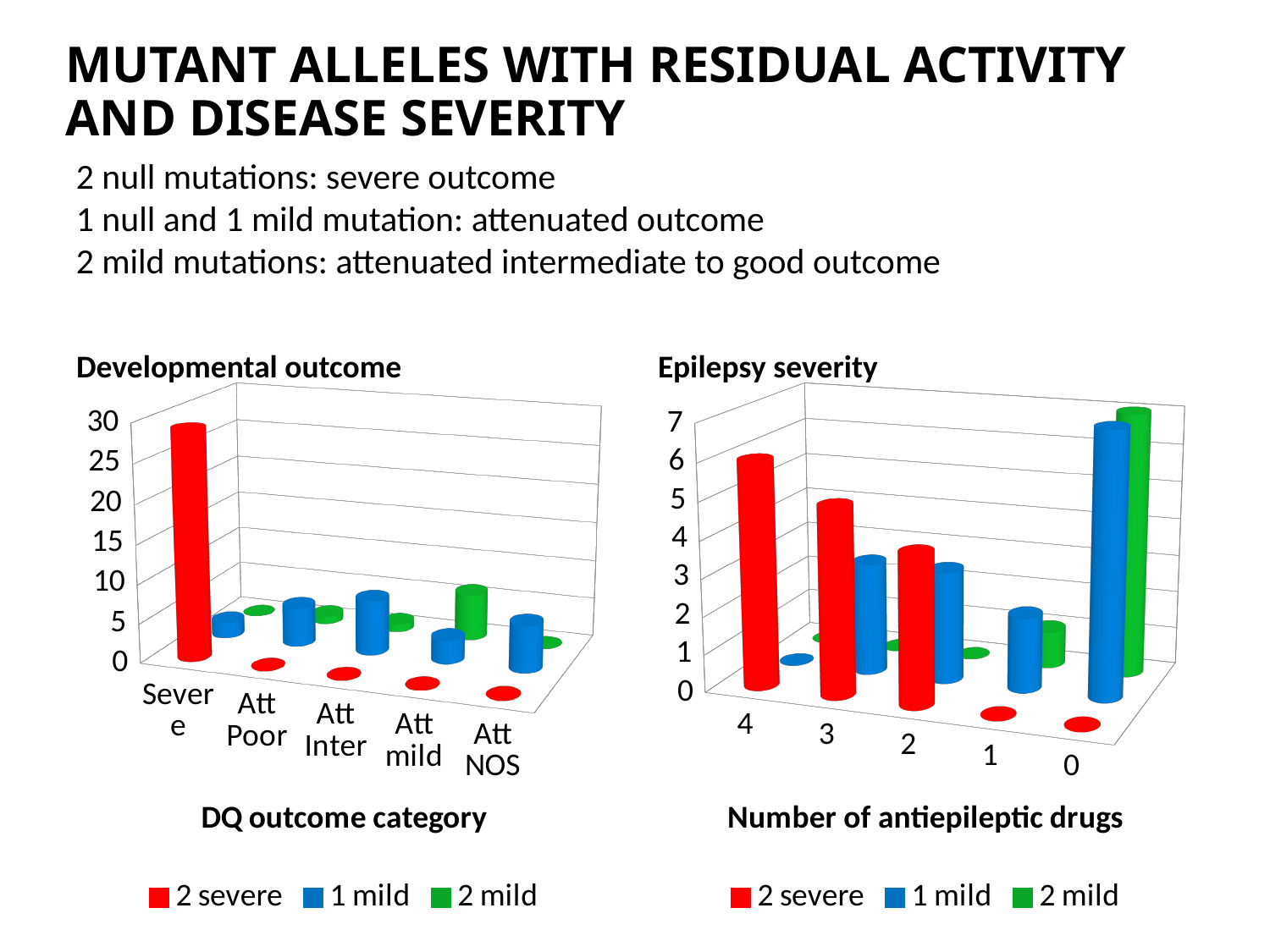
In the Developmental outcome chart, which DQ outcome category has the highest value for the 2 severe series? Severe In the Epilepsy severity chart, is the 1 mild value for 0 antiepileptic drugs greater or less than 4? greater In the Developmental outcome chart, is the 2 severe value for Severe greater or less than 20? greater How many categories are shown on the x axis of the Developmental outcome chart? 5 In the Developmental outcome chart, is the 2 severe value for Att NOS greater or less than 5? less In the Epilepsy severity chart, do the 2 severe values rise or fall going from 4 drugs to 0 drugs along the x axis? fall In the Epilepsy severity chart, which number of antiepileptic drugs has the highest value for the 1 mild series? 0 How many series does the legend of the Epilepsy severity chart list? 3 What is the x-axis title of the Epilepsy severity chart? Number of antiepileptic drugs What kind of chart is the Developmental outcome chart? bar chart In the Epilepsy severity chart, which is larger for the 2 severe series: the value at 4 drugs or the value at 1 drug? 4 drugs